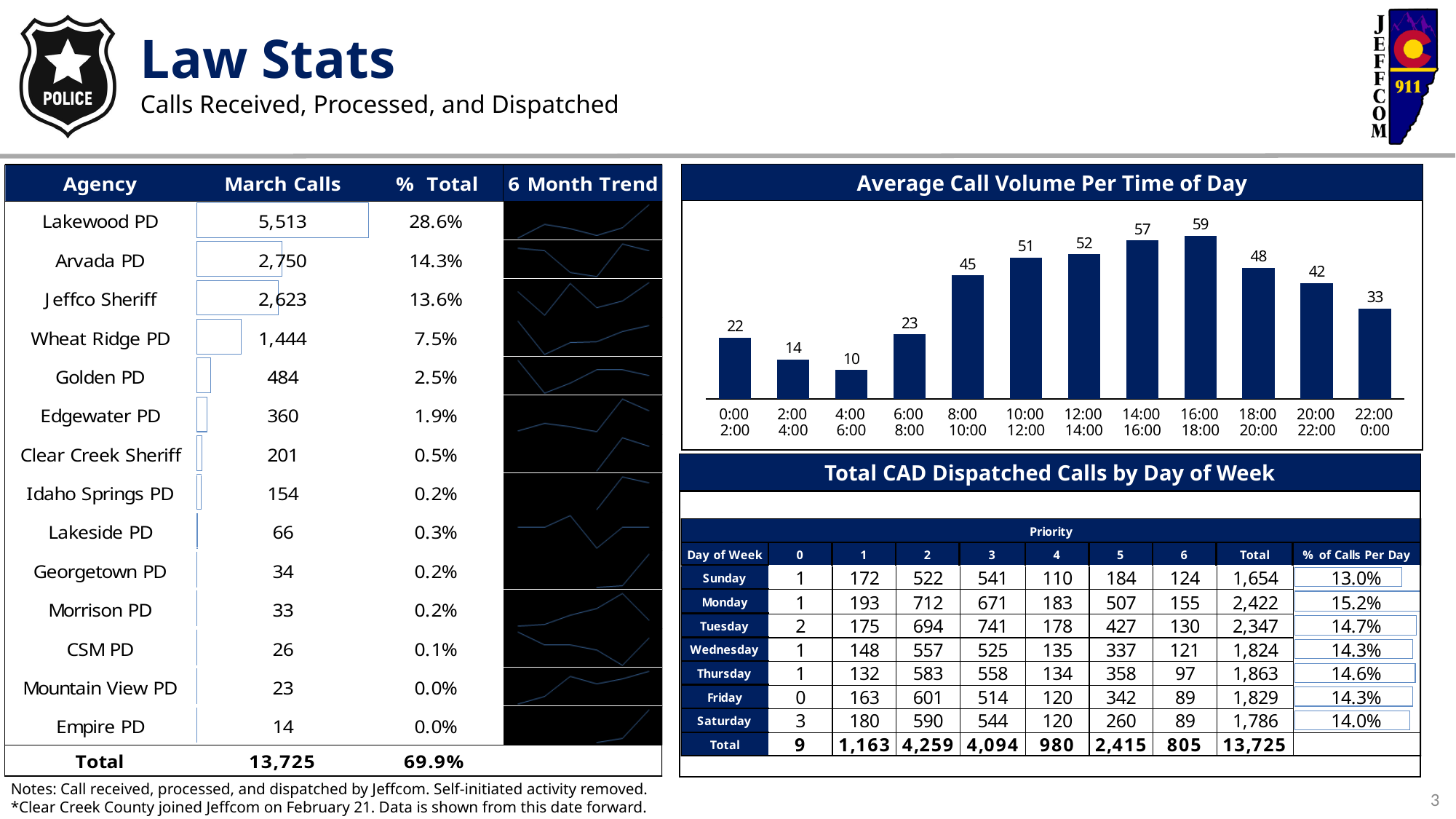
In the 'Average Call Volume Per Time of Day' chart, which is larger: the value for 0:00–2:00 or the value for 6:00–8:00? 6:00–8:00 In the 'Average Call Volume Per Time of Day' chart, which time slot has the highest average call volume? 16:00–18:00 In the 'Average Call Volume Per Time of Day' chart, what is the value for the 16:00–18:00 time slot? 59 What kind of chart is 'Average Call Volume Per Time of Day'? Bar chart In the 'Average Call Volume Per Time of Day' chart, do the values rise or fall from 8:00–10:00 to 16:00–18:00? Rise In the 'Average Call Volume Per Time of Day' chart, what is the value for the 22:00–0:00 time slot? 33 In the 'Average Call Volume Per Time of Day' chart, which time slot has the lowest average call volume? 4:00–6:00 In the 'Average Call Volume Per Time of Day' chart, which is larger: the value for 20:00–22:00 or the value for 22:00–0:00? 20:00–22:00 In the 'Average Call Volume Per Time of Day' chart, what is the value for the 8:00–10:00 time slot? 45 In the 'Average Call Volume Per Time of Day' chart, what is the difference between the 16:00–18:00 value and the 4:00–6:00 value? 49 How many time slots are plotted in the 'Average Call Volume Per Time of Day' chart? 12 In the 'Average Call Volume Per Time of Day' chart, what is the difference between the 14:00–16:00 value and the 18:00–20:00 value? 9